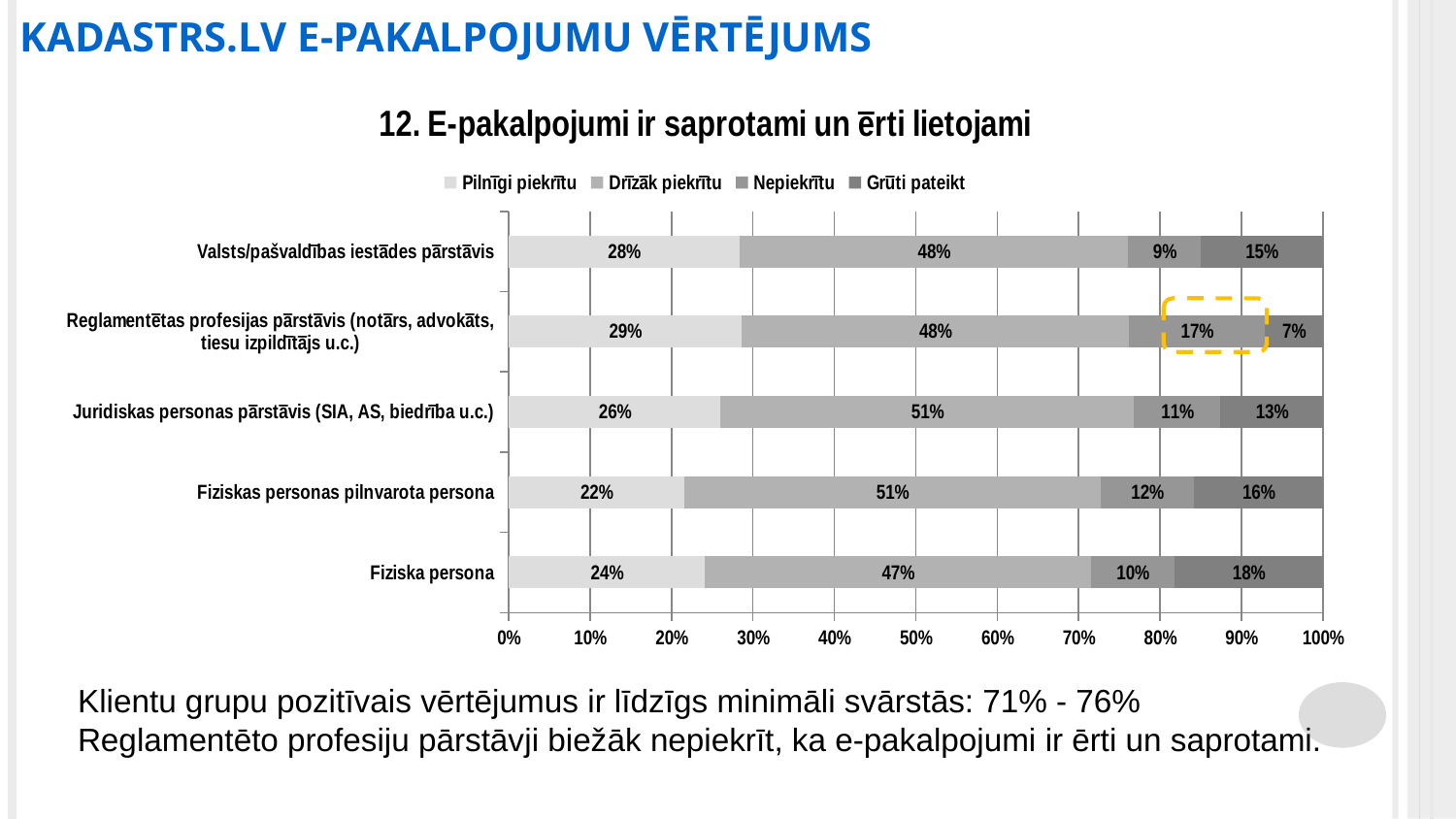
Which legend entry is listed first? Pilnīgi piekrītu What is the difference between the 'Drīzāk piekrītu' values for 'Juridiskas personas pārstāvis (SIA, AS, biedrība u.c.)' and 'Fiziska persona'? 4% Which category has the highest 'Pilnīgi piekrītu' value? Reglamentētas profesijas pārstāvis (notārs, advokāts, tiesu izpildītājs u.c.) What is the 'Nepiekrītu' value for 'Reglamentētas profesijas pārstāvis (notārs, advokāts, tiesu izpildītājs u.c.)'? 17% What is the title of the chart? 12. E-pakalpojumi ir saprotami un ērti lietojami How many respondent categories are shown on the chart? 5 Which is larger: the 'Grūti pateikt' value for 'Fiziska persona' or for 'Reglamentētas profesijas pārstāvis (notārs, advokāts, tiesu izpildītājs u.c.)'? Fiziska persona How many series does the legend list? 4 What type of chart is shown on the slide? Bar chart What is the 'Pilnīgi piekrītu' value for 'Fiziska persona'? 24% What is the 'Grūti pateikt' value for 'Valsts/pašvaldības iestādes pārstāvis'? 15% Which category has the lowest 'Pilnīgi piekrītu' value? Fiziskas personas pilnvarota persona